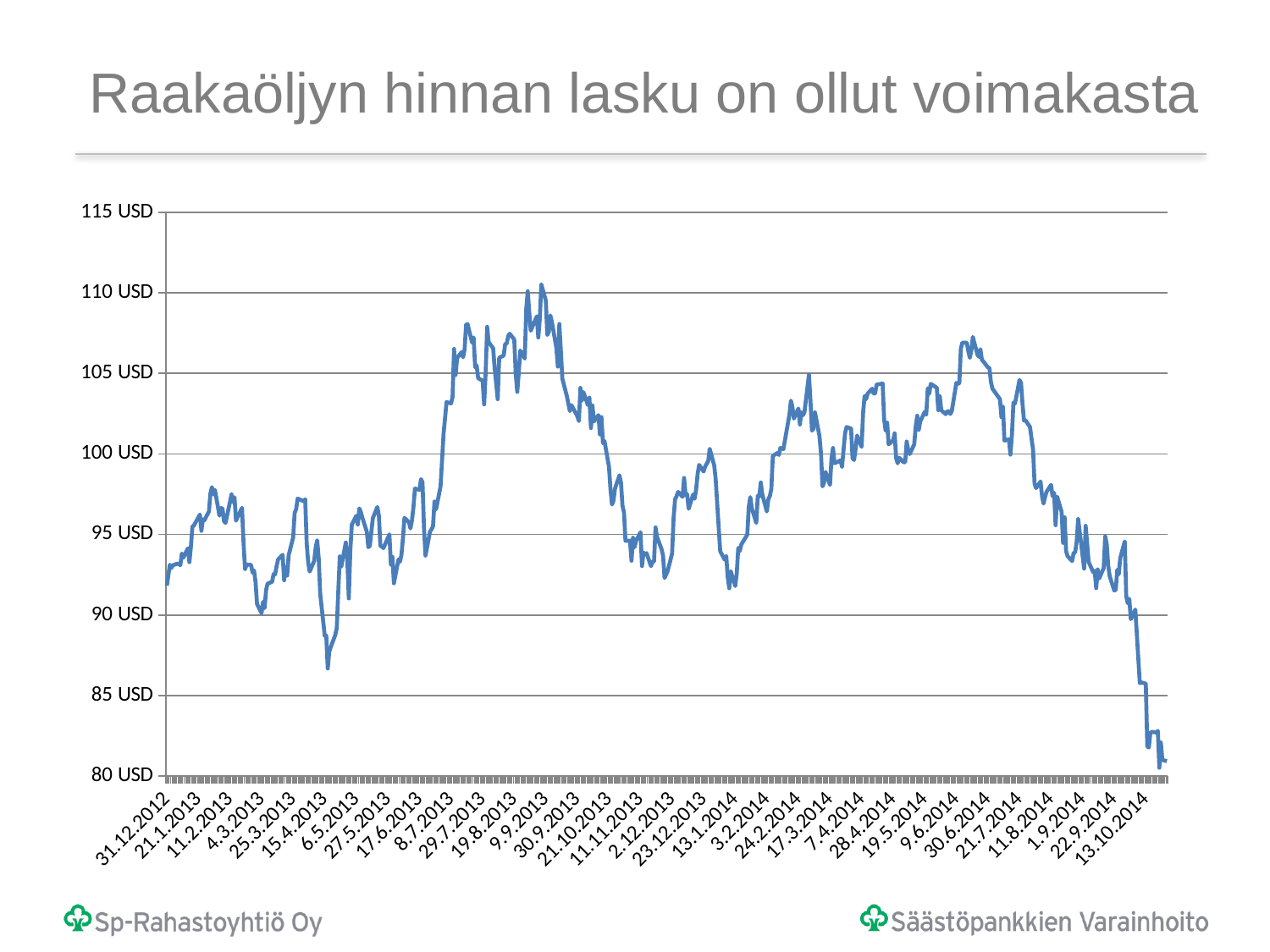
Which is higher, the value at 9.9.2013 or the value at 13.10.2014? 9.9.2013 What kind of chart is shown on the slide? line chart Does the line rise or fall between 15.4.2013 and 8.7.2013? rise What is the title of the slide? Raakaöljyn hinnan lasku on ollut voimakasta Does the line rise or fall between 22.9.2014 and 13.10.2014? fall Is the value at 9.9.2013 greater or less than 105 USD? greater What is the highest value shown on the vertical axis? 115 USD Is the value at 31.12.2012 greater or less than 95 USD? less Is the value at 22.9.2014 greater or less than 95 USD? less